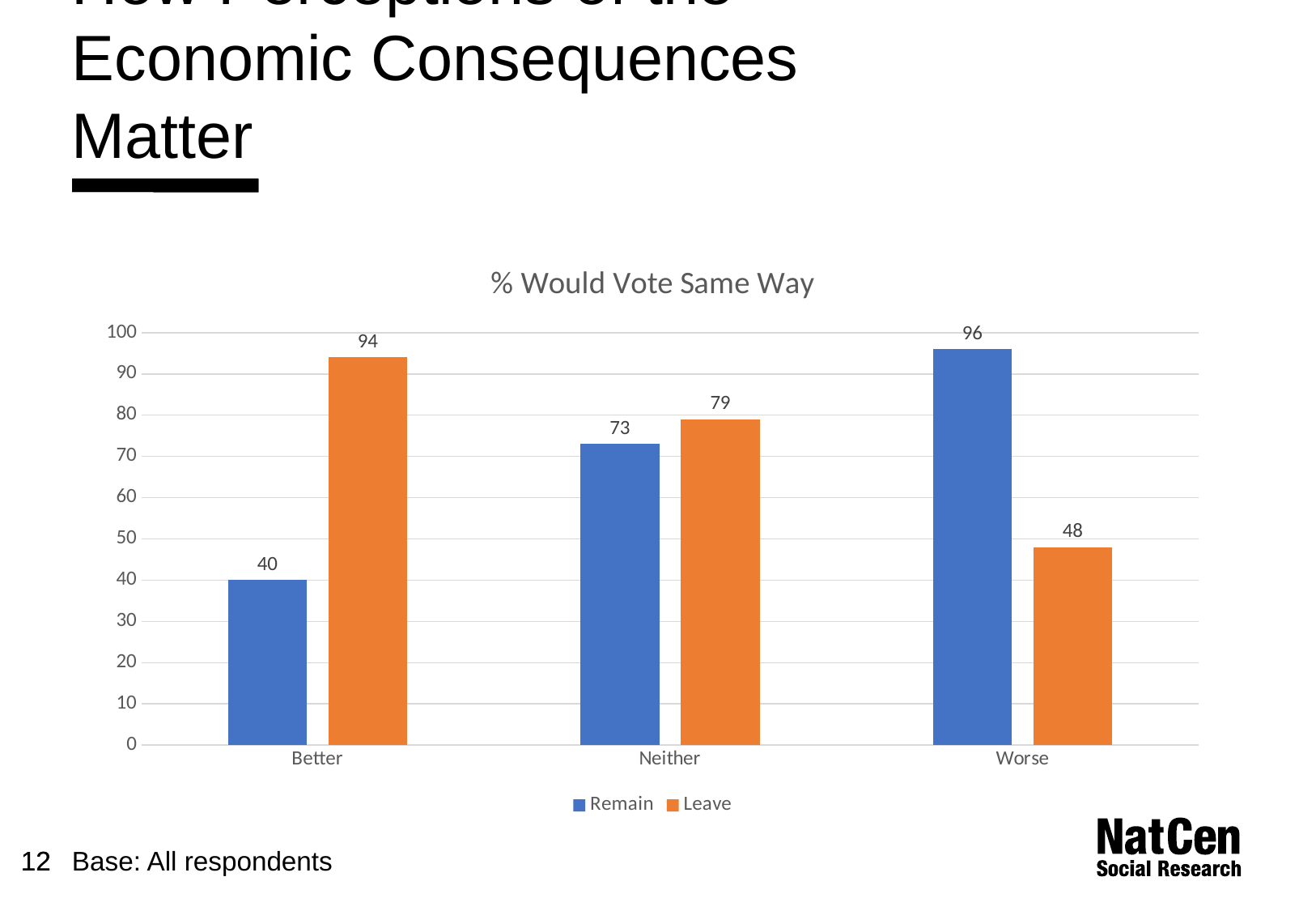
How many series does the legend list? 2 Which category has the lowest value for Leave? Worse Is the value for Remain in the Worse category greater or less than 90? greater How many categories are shown on the x axis? 3 What is the value for Leave in the Worse category? 48 What is the value for Leave in the Neither category? 79 What is the difference between the Leave and Remain values in the Better category? 54 What is the title of the chart? % Would Vote Same Way What kind of chart is shown on the slide? Bar chart Which category has the highest value for Remain? Worse Which is larger in the Neither category, Remain or Leave? Leave What is the value for Remain in the Better category? 40